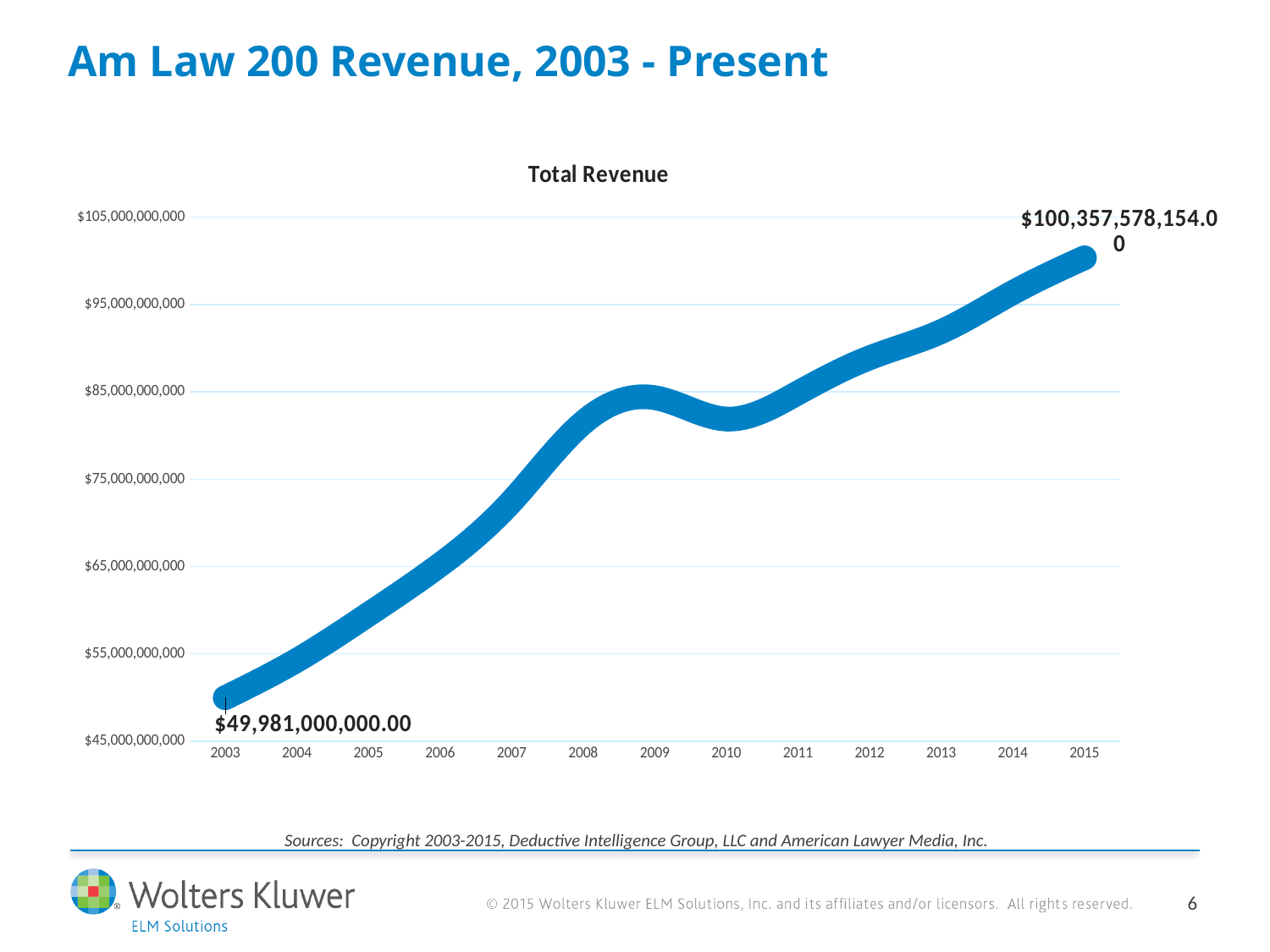
What is the difference between the 2015 and 2003 total revenue values? $50,376,578,154.00 Is the value for 2012 greater or less than $85,000,000,000? greater How many years are plotted on the x axis? 13 Which year has the higher total revenue, 2008 or 2011? 2011 What is the total revenue value shown for 2003? $49,981,000,000.00 Is the value for 2007 greater or less than $75,000,000,000? less Which year has the highest total revenue? 2015 Does total revenue generally rise or fall from 2003 to 2015? Rise What kind of chart is shown on the slide? Line chart Which year has the lowest total revenue? 2003 What is the total revenue value shown for 2015? $100,357,578,154.00 Is the value for 2009 greater or less than $75,000,000,000? greater